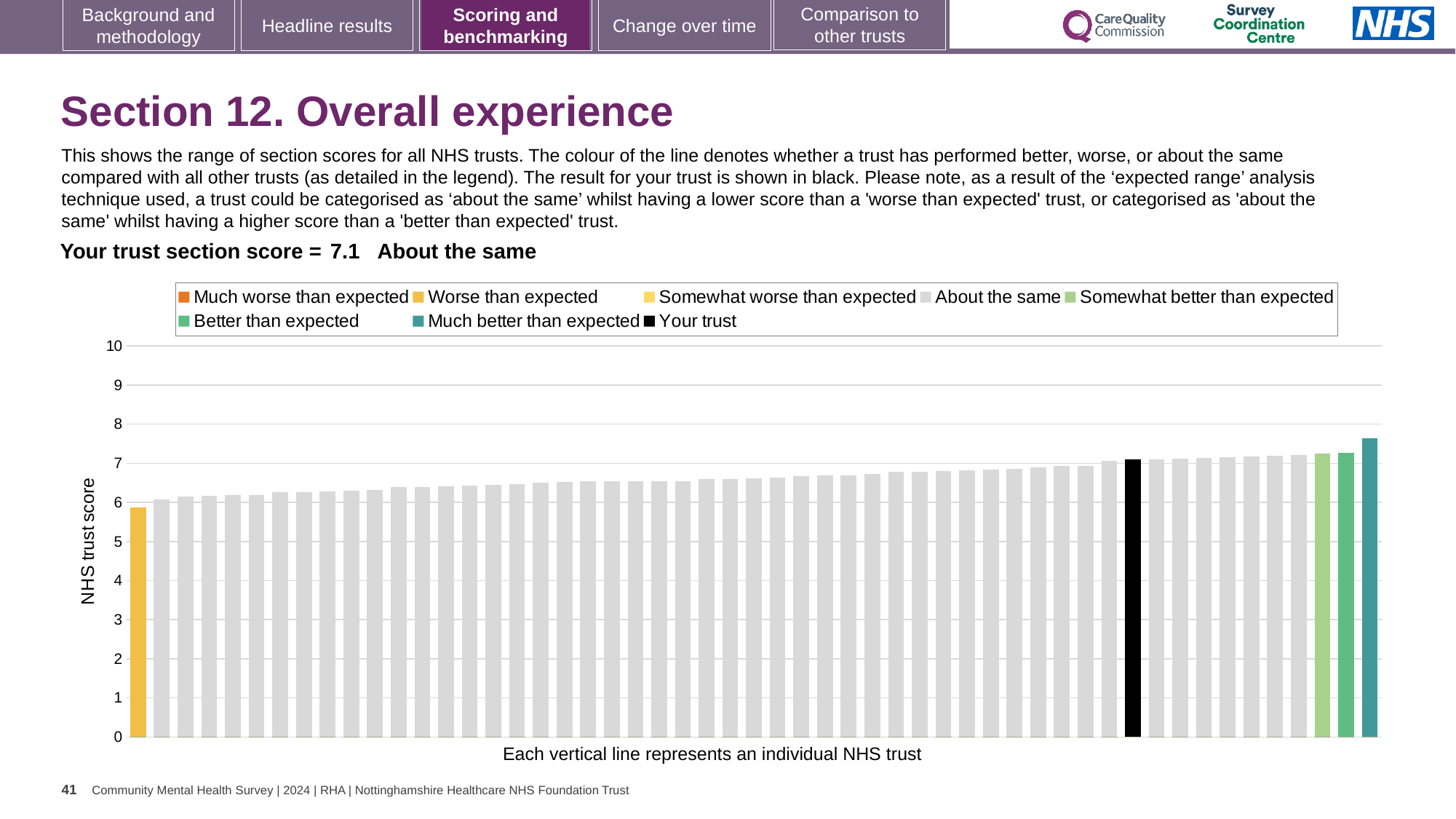
How many entries does the chart legend list? 8 Which legend category does the highest bar on the chart belong to? Much better than expected Do the bar values rise or fall from left to right along the x axis? Rise Which legend category does the lowest bar on the chart belong to? Worse than expected What is the label on the vertical axis of the chart? NHS trust score What kind of chart is shown on the slide? Bar chart What colour is the bar representing your trust? Black Is the value of the black 'Your trust' bar greater or less than 5? greater Is the value of the shortest bar (the yellow 'Worse than expected' bar) greater or less than 5? greater Is the value of the tallest bar (the teal 'Much better than expected' bar) greater or less than 8? less What is the section score for your trust shown on the slide? 7.1 How is your trust categorised compared with other trusts, according to the text above the chart? About the same